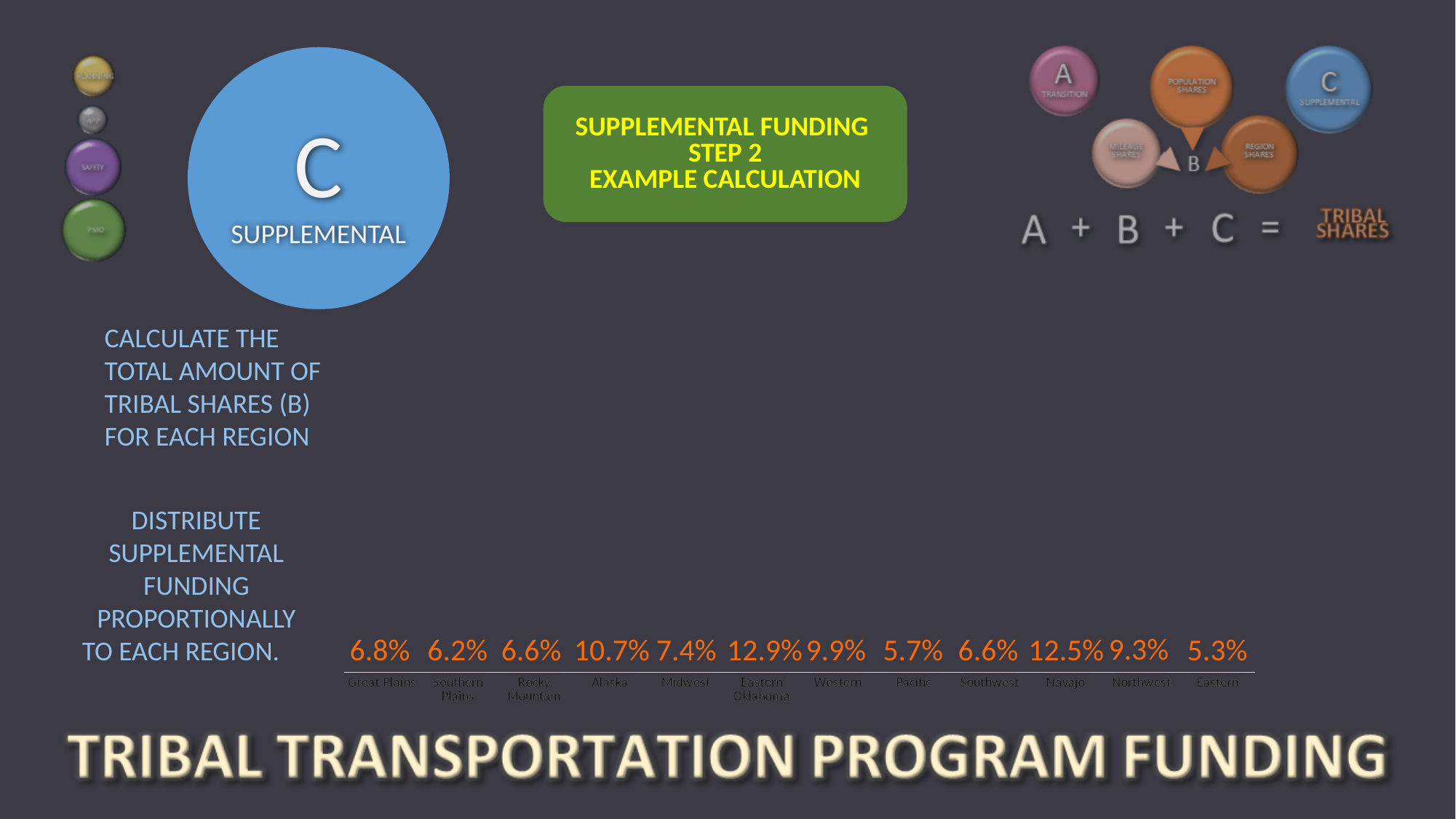
What is the difference between the values for Alaska and Midwest? 3.3% What is the value shown for Alaska? 10.7% What is the value shown for Pacific? 5.7% Which region has the highest value? Eastern Oklahoma Which two regions share the same value of 6.6%? Rocky Mountain and Southwest Which is larger, the value for Southern Plains or the value for Rocky Mountain? Rocky Mountain What is the value shown for Navajo? 12.5% How many regions are shown along the x axis? 12 What is the difference between the values for Eastern Oklahoma and Navajo? 0.4% What is the value shown for Great Plains? 6.8% Which region has the lowest value? Eastern Which is larger, the value for Western or the value for Northwest? Western